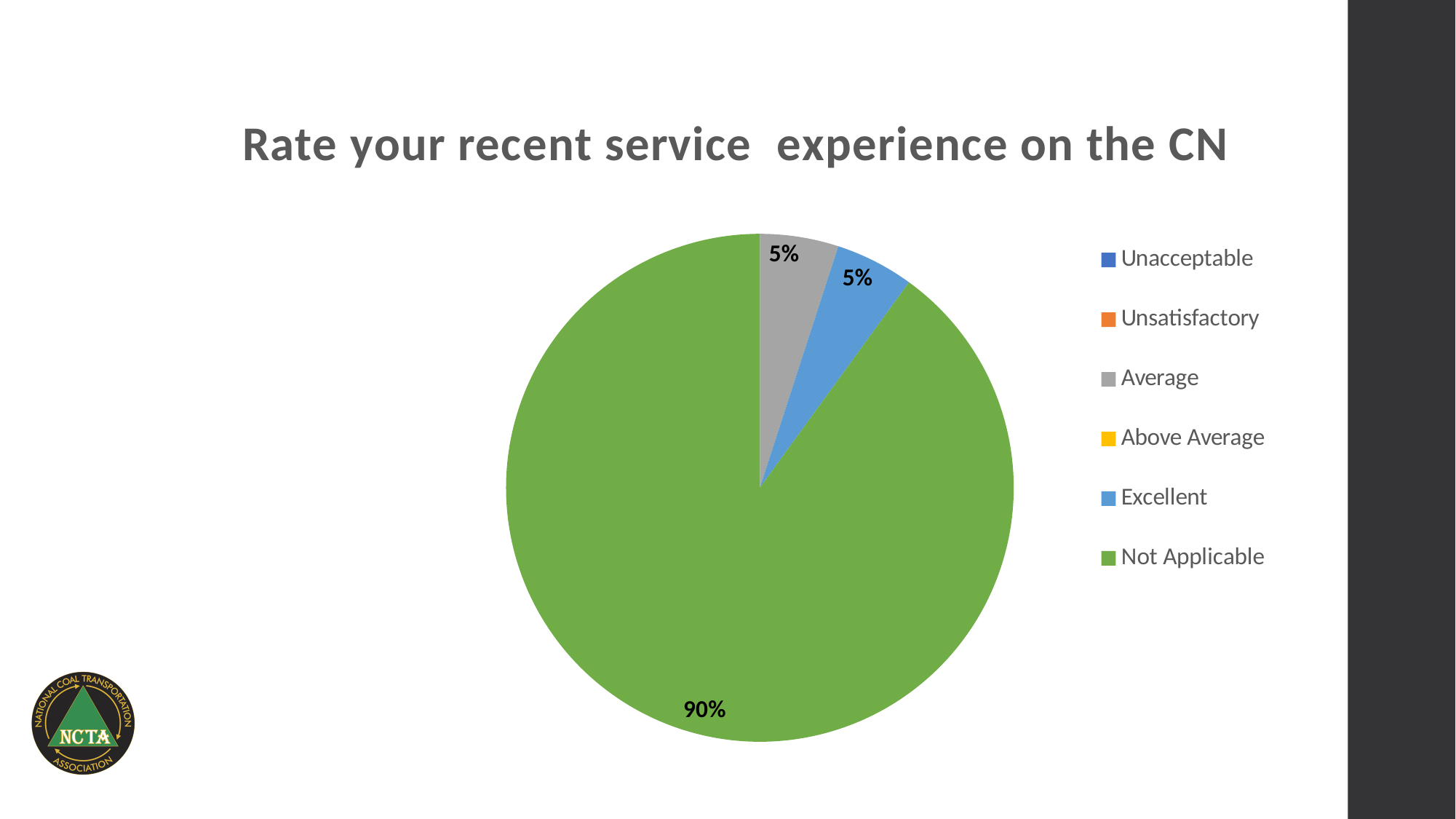
Which category has the largest slice of the pie? Not Applicable What kind of chart is shown on the slide? pie chart How many categories does the legend list? 6 How many slices of the pie have a visible data label? 3 What is the difference between the Not Applicable share and the Average share? 85% What is the combined share of the Average and Excellent slices? 10% What is the title of the chart? Rate your recent service experience on the CN What colour is the Not Applicable slice? green What share of the pie is labelled Not Applicable? 90% Which is larger, the Not Applicable slice or the Excellent slice? Not Applicable What share of the pie is labelled Excellent? 5% What share of the pie is labelled Average? 5%